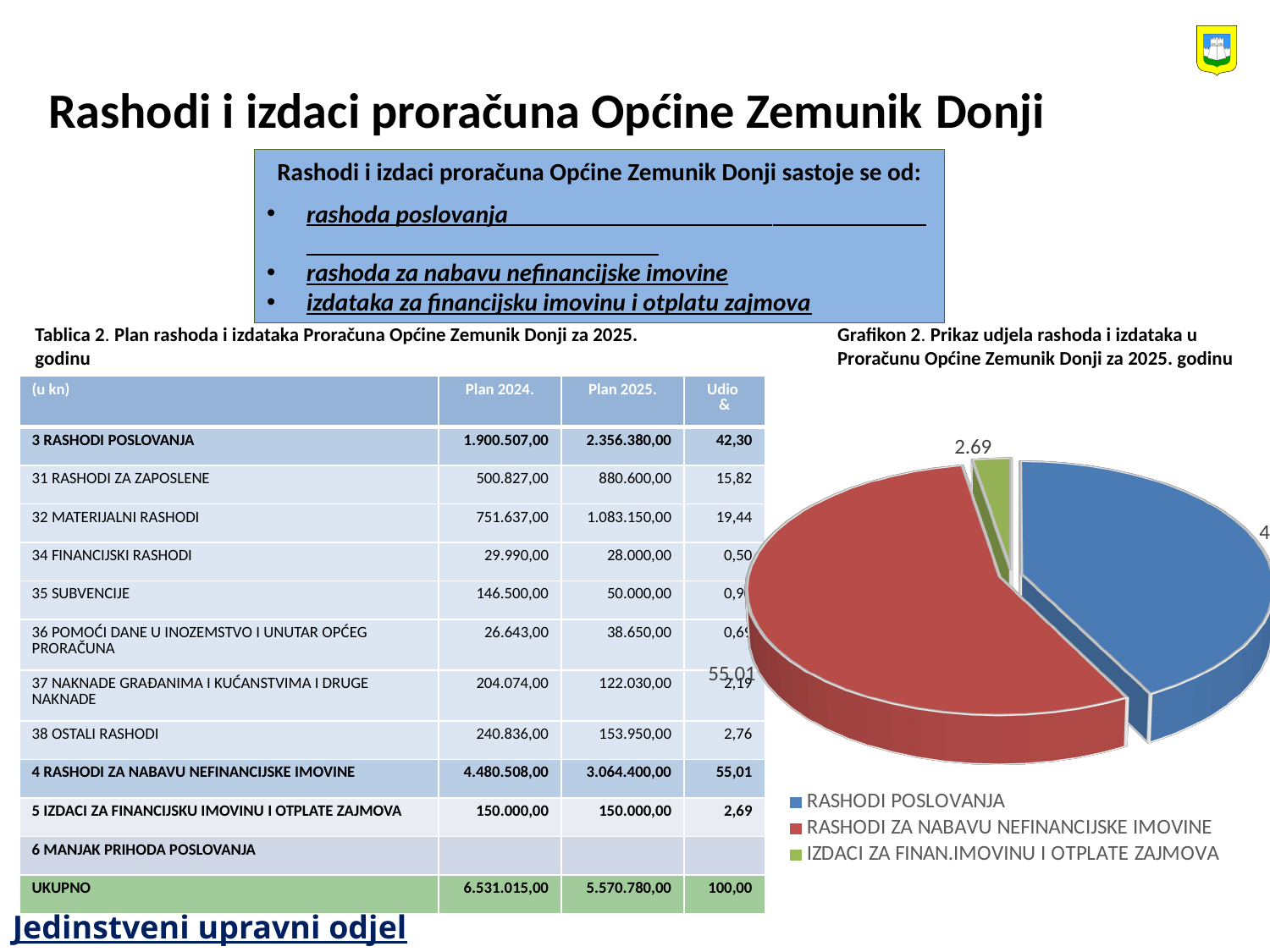
Which category has the largest slice in Grafikon 2? RASHODI ZA NABAVU NEFINANCIJSKE IMOVINE How many entries does the legend of Grafikon 2 list? 3 In Grafikon 2, which is larger: RASHODI POSLOVANJA or IZDACI ZA FINAN.IMOVINU I OTPLATE ZAJMOVA? RASHODI POSLOVANJA In Grafikon 2, what colour is the slice for RASHODI POSLOVANJA? blue In Grafikon 2, which is larger: RASHODI POSLOVANJA or RASHODI ZA NABAVU NEFINANCIJSKE IMOVINE? RASHODI ZA NABAVU NEFINANCIJSKE IMOVINE In Grafikon 2, what value is shown for IZDACI ZA FINAN.IMOVINU I OTPLATE ZAJMOVA? 2,69 How many slices does the pie chart in Grafikon 2 have? 3 Which category has the smallest slice in Grafikon 2? IZDACI ZA FINAN.IMOVINU I OTPLATE ZAJMOVA In Grafikon 2, what is the difference between the values for RASHODI ZA NABAVU NEFINANCIJSKE IMOVINE and IZDACI ZA FINAN.IMOVINU I OTPLATE ZAJMOVA? 52,32 In Grafikon 2, what value is shown for RASHODI ZA NABAVU NEFINANCIJSKE IMOVINE? 55,01 What kind of chart is Grafikon 2 on the slide? pie chart What is the title of the pie chart on the slide? Grafikon 2. Prikaz udjela rashoda i izdataka u Proračunu Općine Zemunik Donji za 2025. godinu